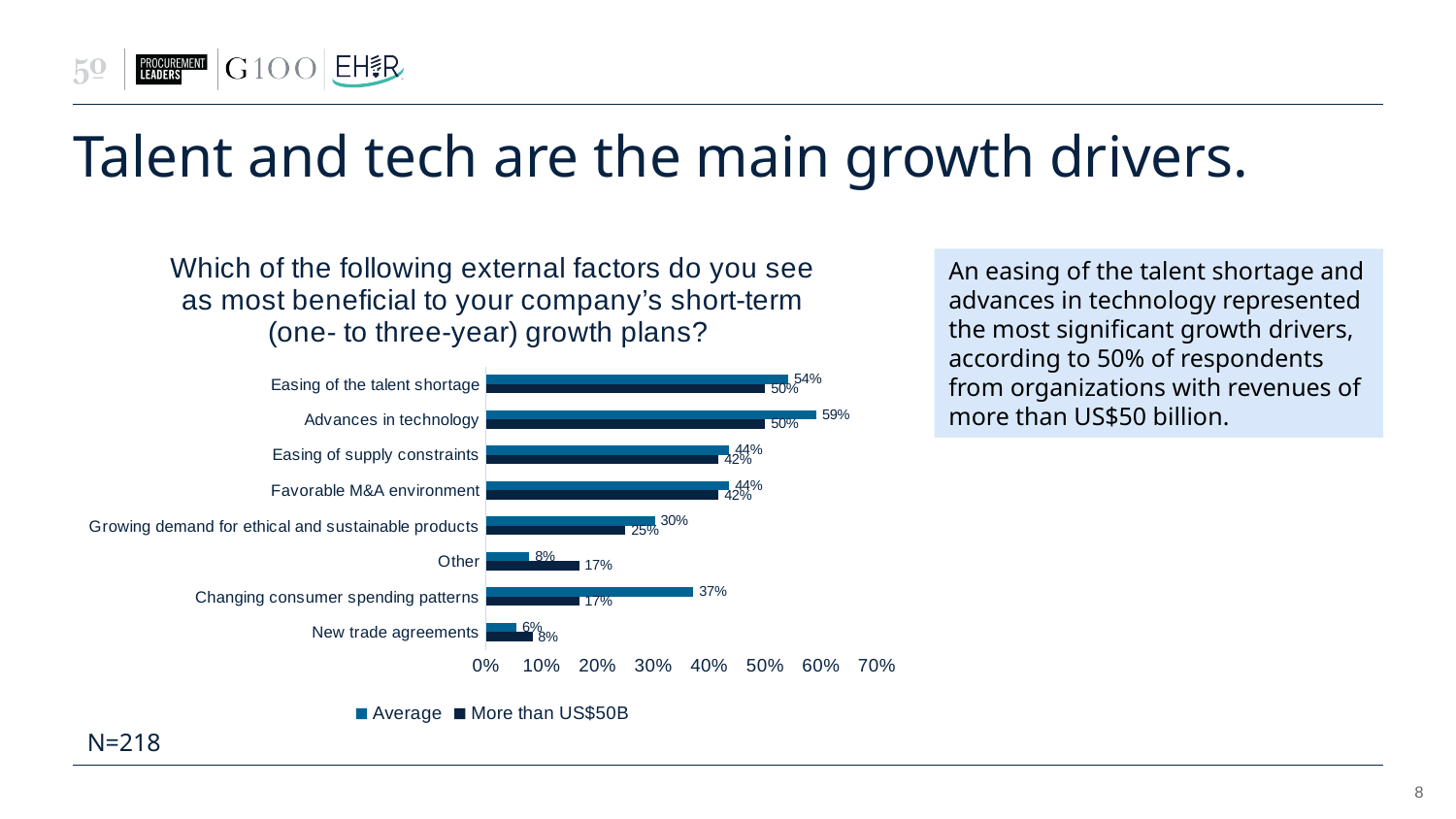
For Other, which series has the larger value, Average or More than US$50B? More than US$50B What is the difference between the Average and More than US$50B values for Changing consumer spending patterns? 20% What is the Average value for Advances in technology? 59% How many series does the legend list? 2 What is the More than US$50B value for Changing consumer spending patterns? 17% How many categories are shown on the chart? 8 Which category has the highest Average value? Advances in technology Which category has the lowest Average value? New trade agreements What kind of chart is shown on the slide? Bar chart What are the two series named in the chart legend? Average and More than US$50B What is the Average value for Growing demand for ethical and sustainable products? 30% Is the Average value for Easing of the talent shortage greater or less than 50%? greater